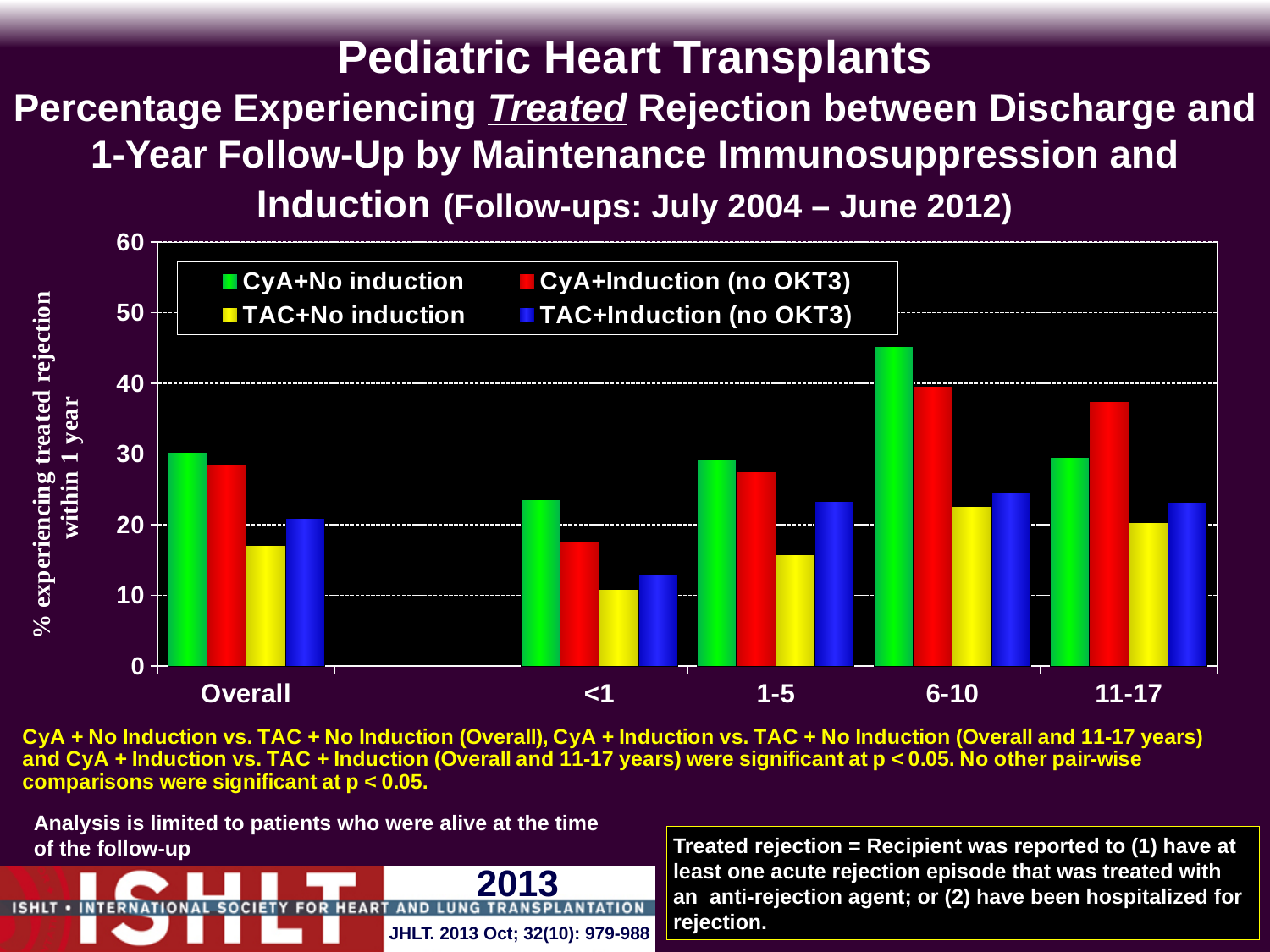
Is the value for CyA+Induction (no OKT3) in the 6-10 group greater or less than 30? greater What kind of chart is shown on the slide? bar chart In the Overall category, which series has the lowest value? TAC+No induction Which age group has the highest value for CyA+No induction? 6-10 Which age group has the lowest value for TAC+No induction? <1 How many categories are shown along the x axis? 5 Is the value for CyA+No induction in the 6-10 group greater or less than 40? greater In the Overall category, which is larger: TAC+No induction or TAC+Induction (no OKT3)? TAC+Induction (no OKT3) In the 11-17 group, which is larger: CyA+No induction or CyA+Induction (no OKT3)? CyA+Induction (no OKT3) What colour represents TAC+No induction in the legend? yellow Is the value for TAC+No induction in the <1 group greater or less than 20? less How many series does the legend list? 4